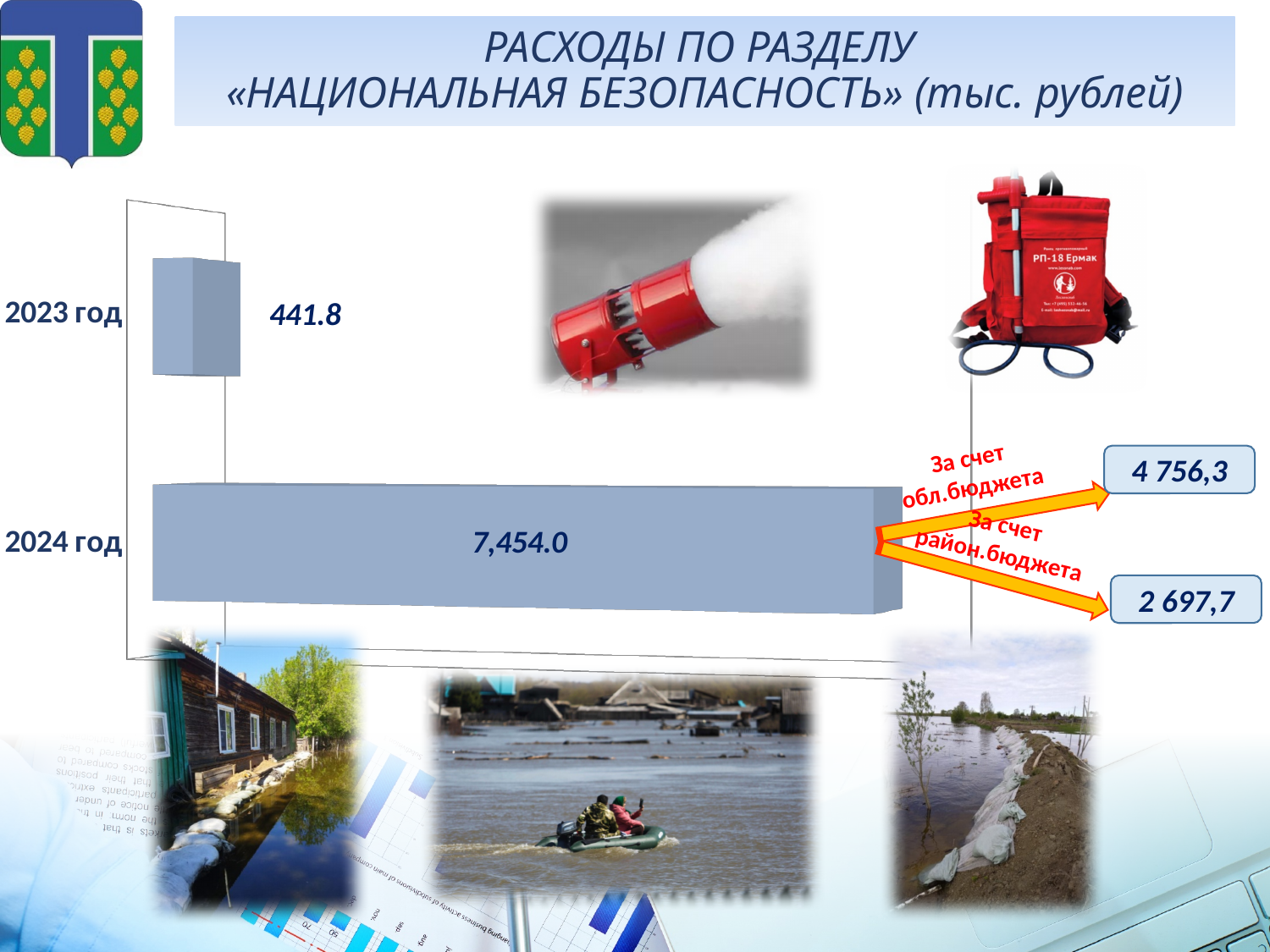
Do the expenditures rise or fall from 2023 год to 2024 год? rise In what units are the expenditures given according to the chart title? тыс. рублей Which year has the higher expenditure, 2023 год or 2024 год? 2024 год How much of the 2024 год expenditure is funded за счет район.бюджета? 2 697,7 How many years (categories) are shown in the bar chart? 2 What is the value for 2023 год? 441.8 By how much does the 2024 год value exceed the 2023 год value? 7,012.2 Is the value for 2024 год larger or smaller than the value for 2023 год? larger Which year has the lower expenditure? 2023 год What kind of chart is used to show the expenditures by year? bar chart What is the value for 2024 год? 7,454.0 How much of the 2024 год expenditure is funded за счет обл.бюджета? 4 756,3